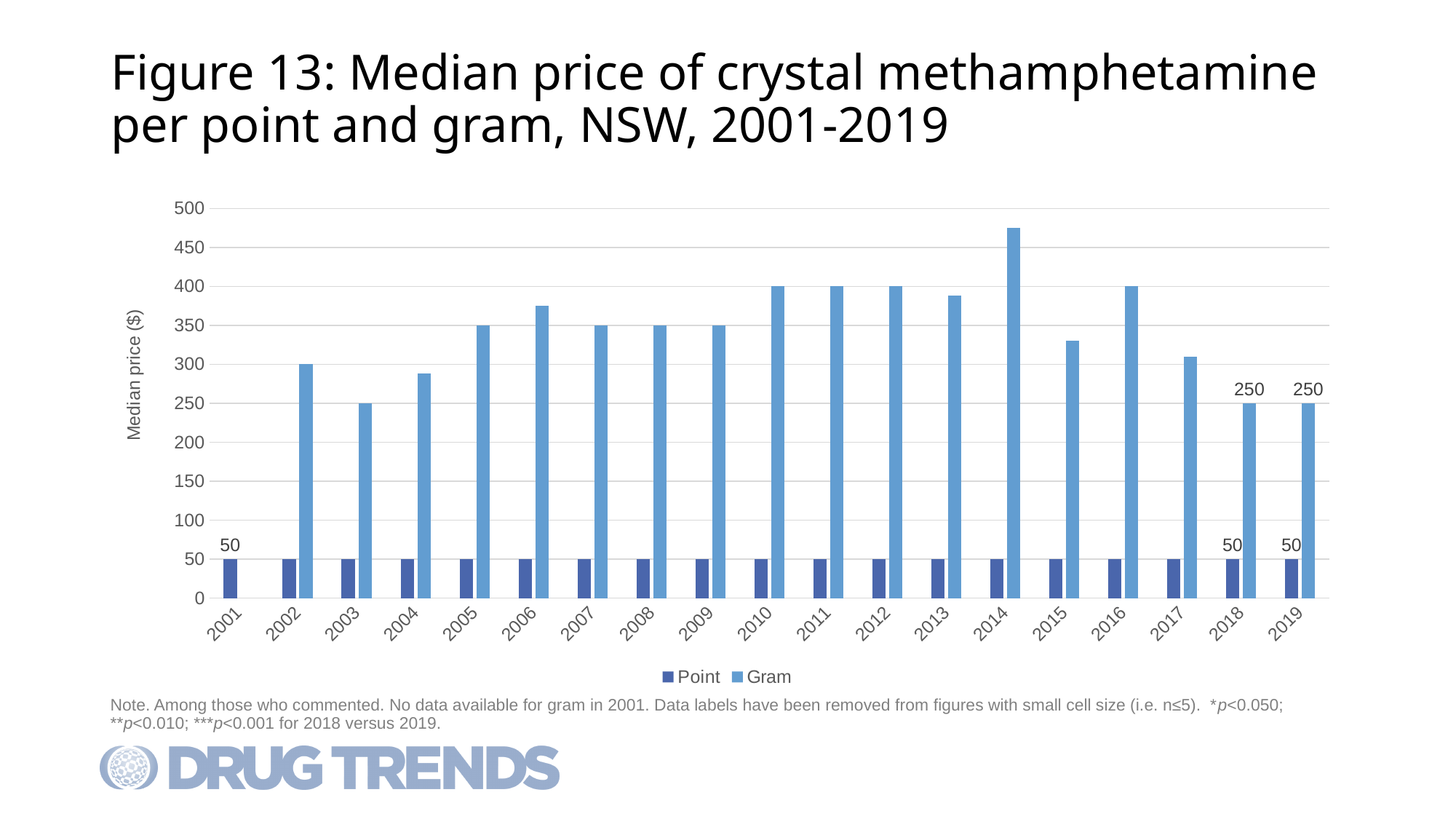
What is the median price per gram in 2018? 250 What is the median price per point in 2001? 50 Is the median price per gram in 2004 greater or less than 300? less What is the median price per gram in 2019? 250 How many series does the legend list? 2 In which year is the median price per gram highest? 2014 What kind of chart is shown on the slide? Bar chart How many years are shown on the x axis? 19 What is the difference between the gram price and the point price in 2019? 200 Is the median price per gram in 2014 greater or less than 450? greater What is the median price per gram in 2010? 400 Which is larger, the median price per gram in 2014 or in 2016? 2014